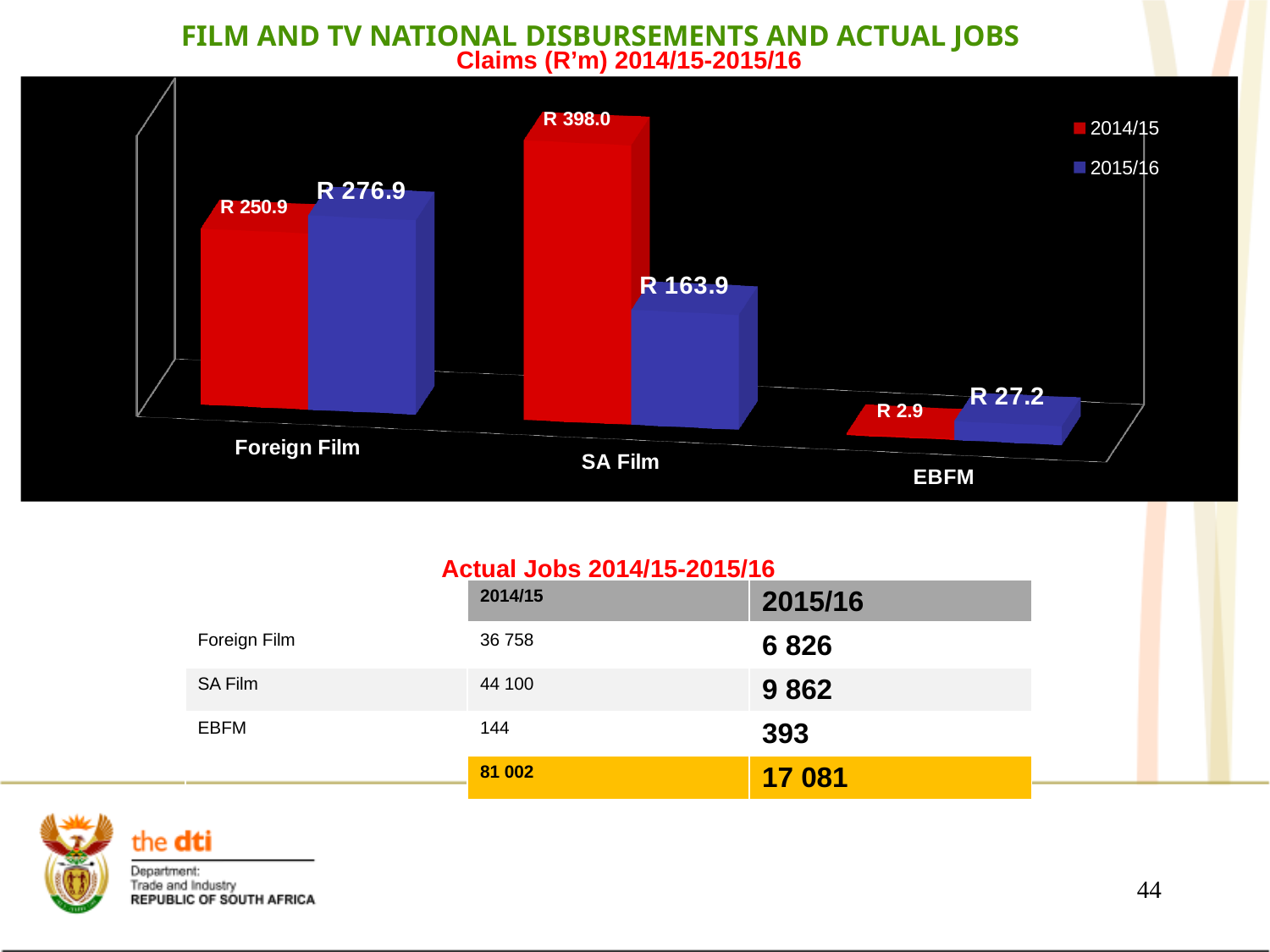
What is the 2014/15 claims value for SA Film? R 398.0 How many series does the chart legend list? 2 Which colour represents the 2015/16 series in the chart? Blue What kind of chart is shown on the slide? Bar chart Which category has the lowest 2015/16 claims value? EBFM How many categories are shown on the x axis of the chart? 3 Which category has the highest 2014/15 claims value? SA Film For Foreign Film, which year has the larger claims value, 2014/15 or 2015/16? 2015/16 What is the difference between the 2014/15 and 2015/16 claims values for SA Film? R 234.1 What is the 2015/16 claims value for Foreign Film? R 276.9 What is the 2014/15 claims value for EBFM? R 2.9 What is the 2015/16 claims value for EBFM? R 27.2